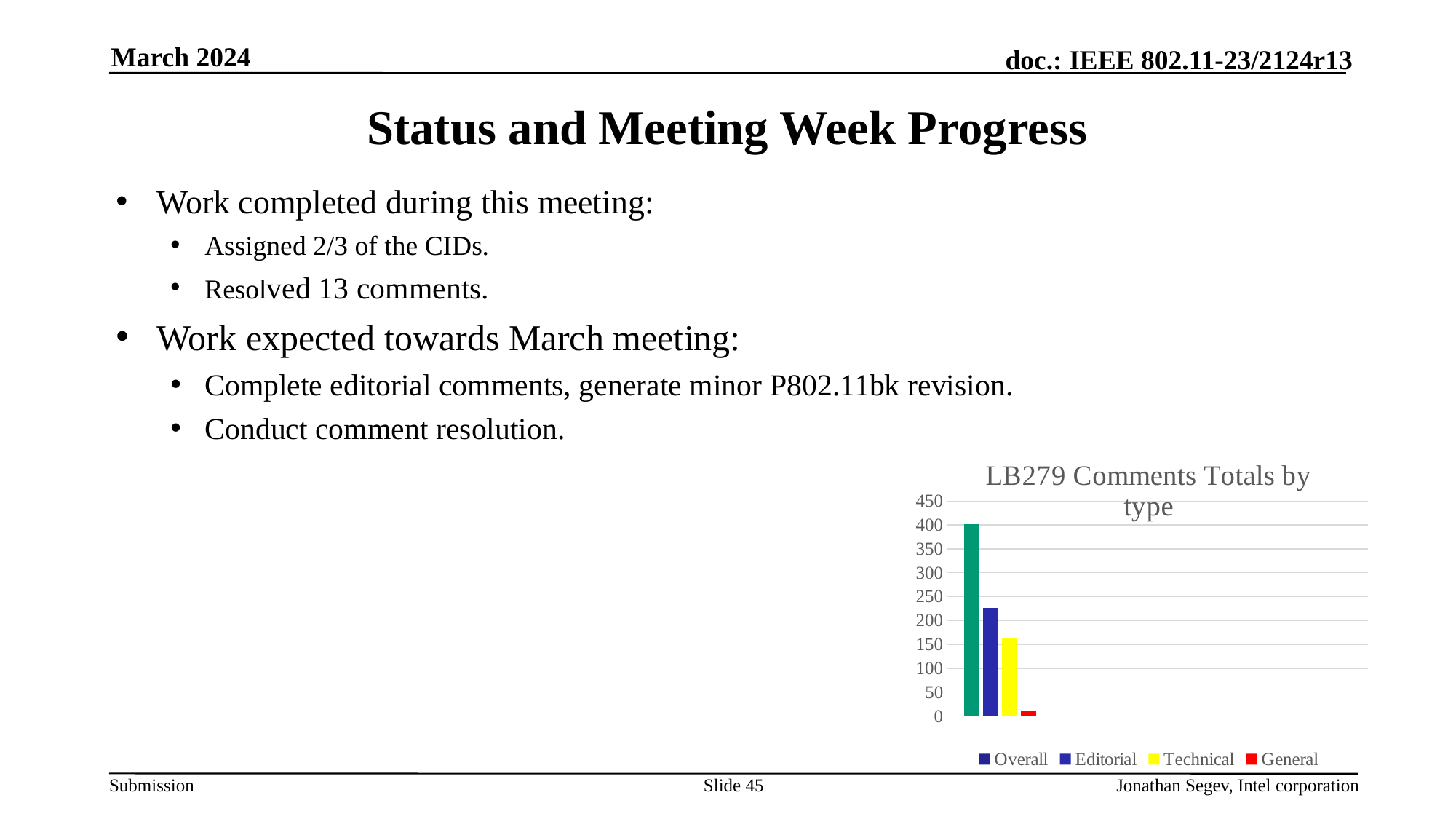
Which is larger, the value for Technical or the value for General? Technical How many series does the chart legend list? 4 Which series has the lowest value in the chart? General What is the title of the chart on the slide? LB279 Comments Totals by type Is the value for Editorial greater or less than 200? greater Which is larger, the value for Editorial or the value for Technical? Editorial What kind of chart is shown on the slide? bar chart Is the value for General greater or less than 50? less Is the value for Technical greater or less than 200? less Which series has the highest value in the chart? Overall What colour is the bar for the Technical series? yellow